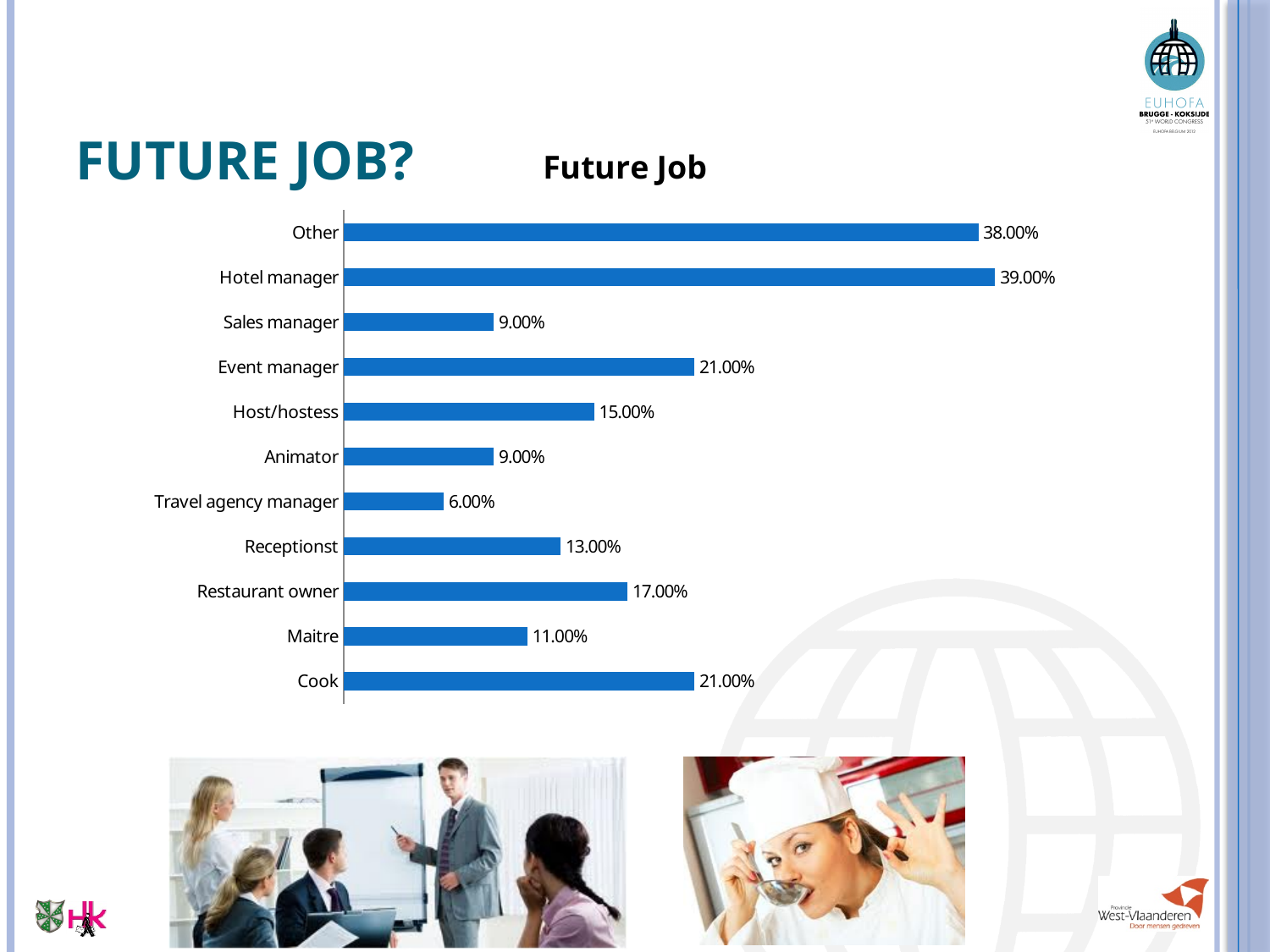
What is the title of the chart? Future Job What is the value for Restaurant owner? 17.00% What is the value for Maitre? 11.00% What is the value for Travel agency manager? 6.00% What is the difference between the values for Hotel manager and Other? 1.00% Which category has the highest value? Hotel manager What is the value for Hotel manager? 39.00% Which category has the lowest value? Travel agency manager How many categories are shown in the chart? 11 What is the difference between the values for Event manager and Host/hostess? 6.00% What kind of chart is shown on the slide? Bar chart Which is larger, the value for Receptionst or the value for Maitre? Receptionst